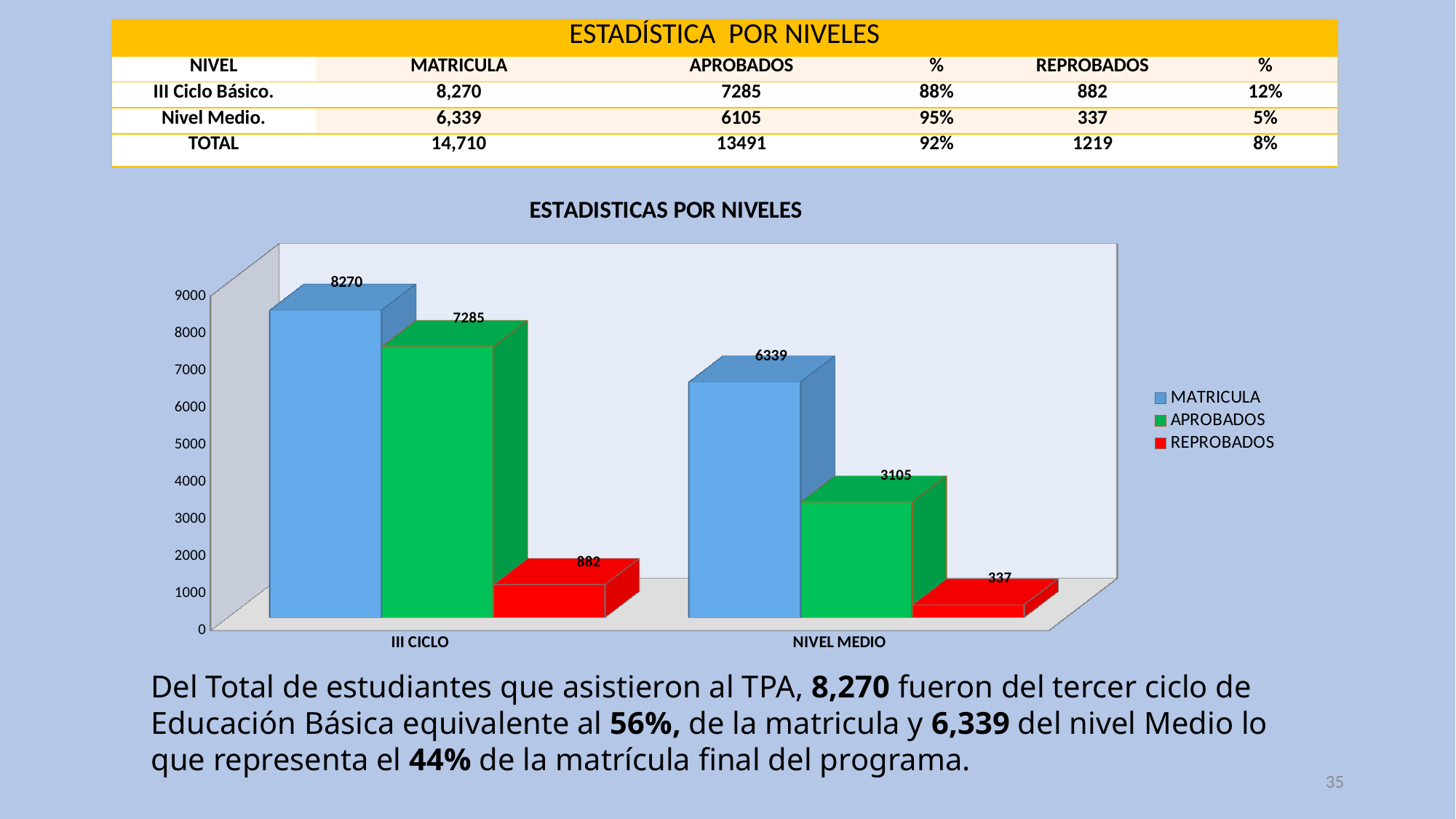
Which is larger in the chart: APROBADOS for III CICLO or APROBADOS for NIVEL MEDIO? APROBADOS for III CICLO What kind of chart is shown on the slide? Bar chart What is the REPROBADOS value for NIVEL MEDIO in the chart? 337 Which category has the highest MATRICULA value in the chart? III CICLO Which series has the lowest value for NIVEL MEDIO in the chart? REPROBADOS What is the APROBADOS value for NIVEL MEDIO in the chart? 3105 What is the difference between the MATRICULA values for III CICLO and NIVEL MEDIO in the chart? 1931 What is the title of the chart? ESTADISTICAS POR NIVELES What is the REPROBADOS value for III CICLO in the chart? 882 How many series does the chart legend list? 3 How many categories are shown on the x axis of the chart? 2 What is the MATRICULA value for III CICLO in the chart? 8270